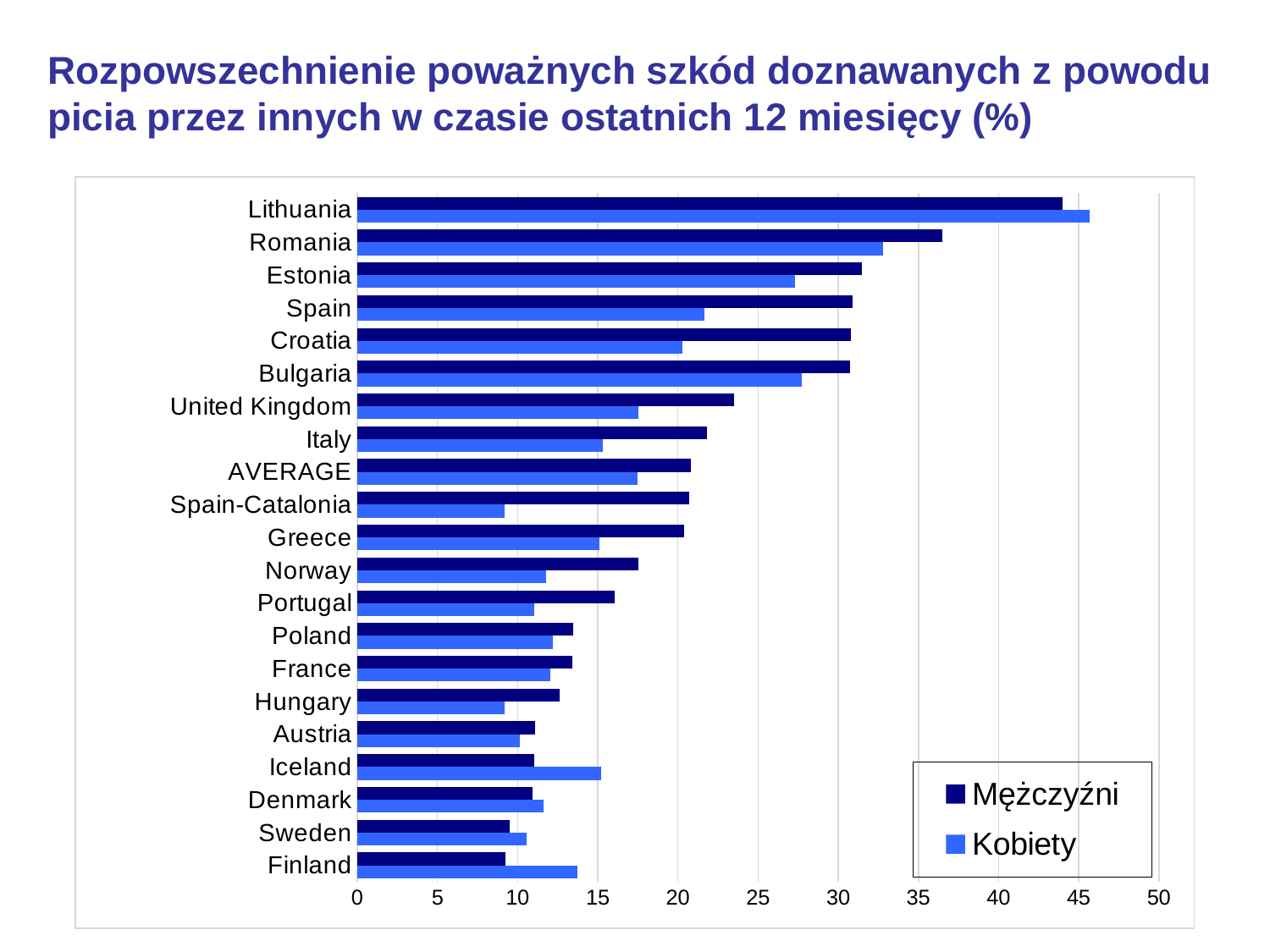
Which series is shown in the lighter blue colour? Kobiety Is the Kobiety value for Spain-Catalonia greater or less than 10? less Is the Mężczyźni value for Norway greater or less than 20? less What kind of chart is shown on the slide? bar chart Is the Kobiety value for Estonia greater or less than 30? less How many series does the legend list? 2 For Finland, which series has the larger value, Mężczyźni or Kobiety? Kobiety For Spain, which series has the larger value, Mężczyźni or Kobiety? Mężczyźni How many countries/categories are shown on the y axis? 21 Which category has the highest value for Mężczyźni? Lithuania Which category has the highest value for Kobiety? Lithuania